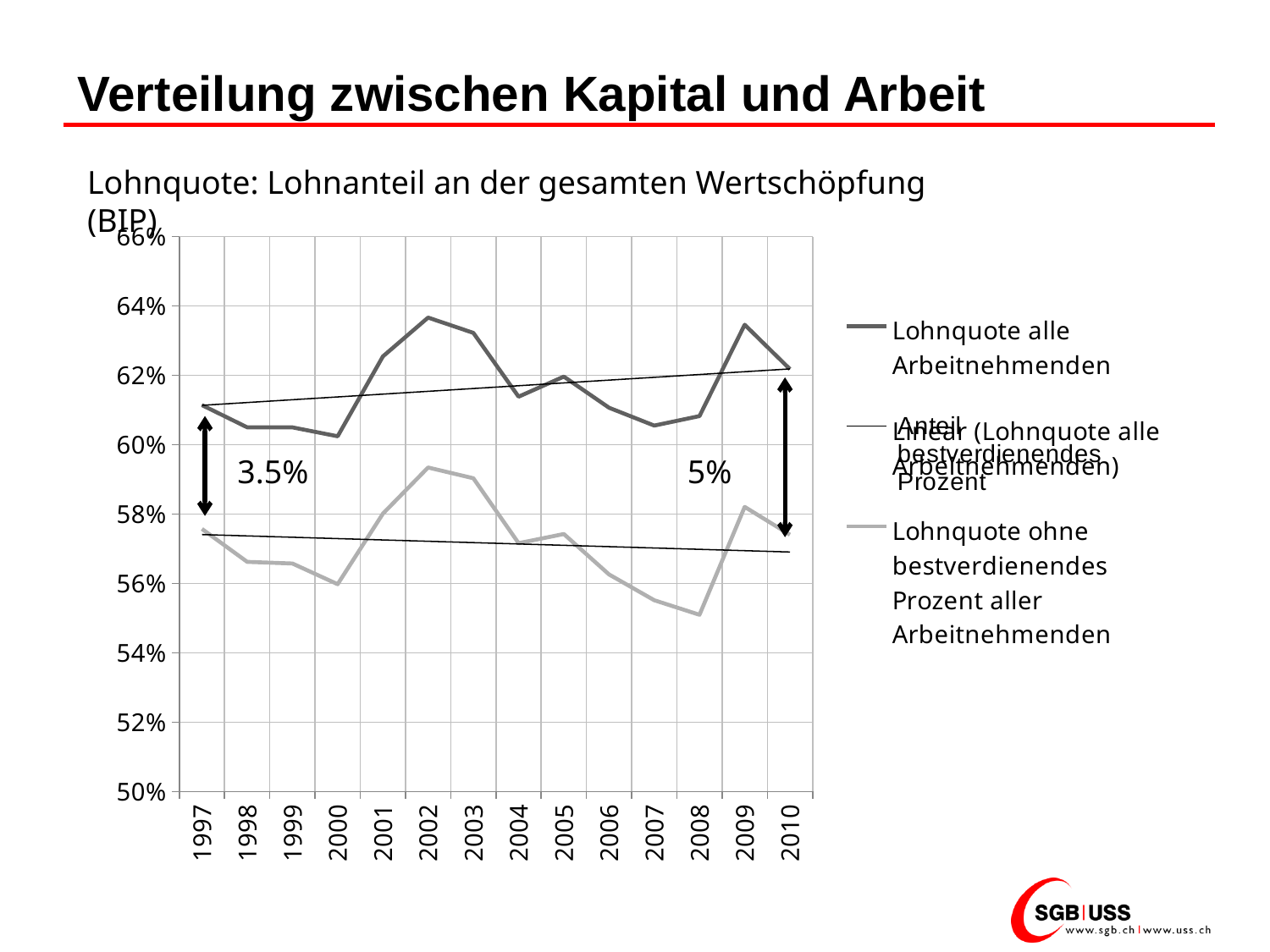
How many years are shown on the x axis of the chart? 14 Is the value for 'Lohnquote alle Arbeitnehmenden' in 2002 greater or less than 62%? greater Is the value for 'Lohnquote alle Arbeitnehmenden' in 2000 greater or less than 62%? less What is the last year shown on the x axis? 2010 What is the first year shown on the x axis? 1997 In which year is 'Lohnquote ohne bestverdienendes Prozent aller Arbeitnehmenden' at its lowest? 2008 Which series is higher in every year: 'Lohnquote alle Arbeitnehmenden' or 'Lohnquote ohne bestverdienendes Prozent aller Arbeitnehmenden'? Lohnquote alle Arbeitnehmenden What kind of chart is shown on the slide? line chart Does 'Lohnquote ohne bestverdienendes Prozent aller Arbeitnehmenden' rise or fall between 2002 and 2008? fall Is the value for 'Lohnquote ohne bestverdienendes Prozent aller Arbeitnehmenden' in 2002 greater or less than 58%? greater Which is larger for 'Lohnquote alle Arbeitnehmenden': the value in 2002 or the value in 2008? 2002